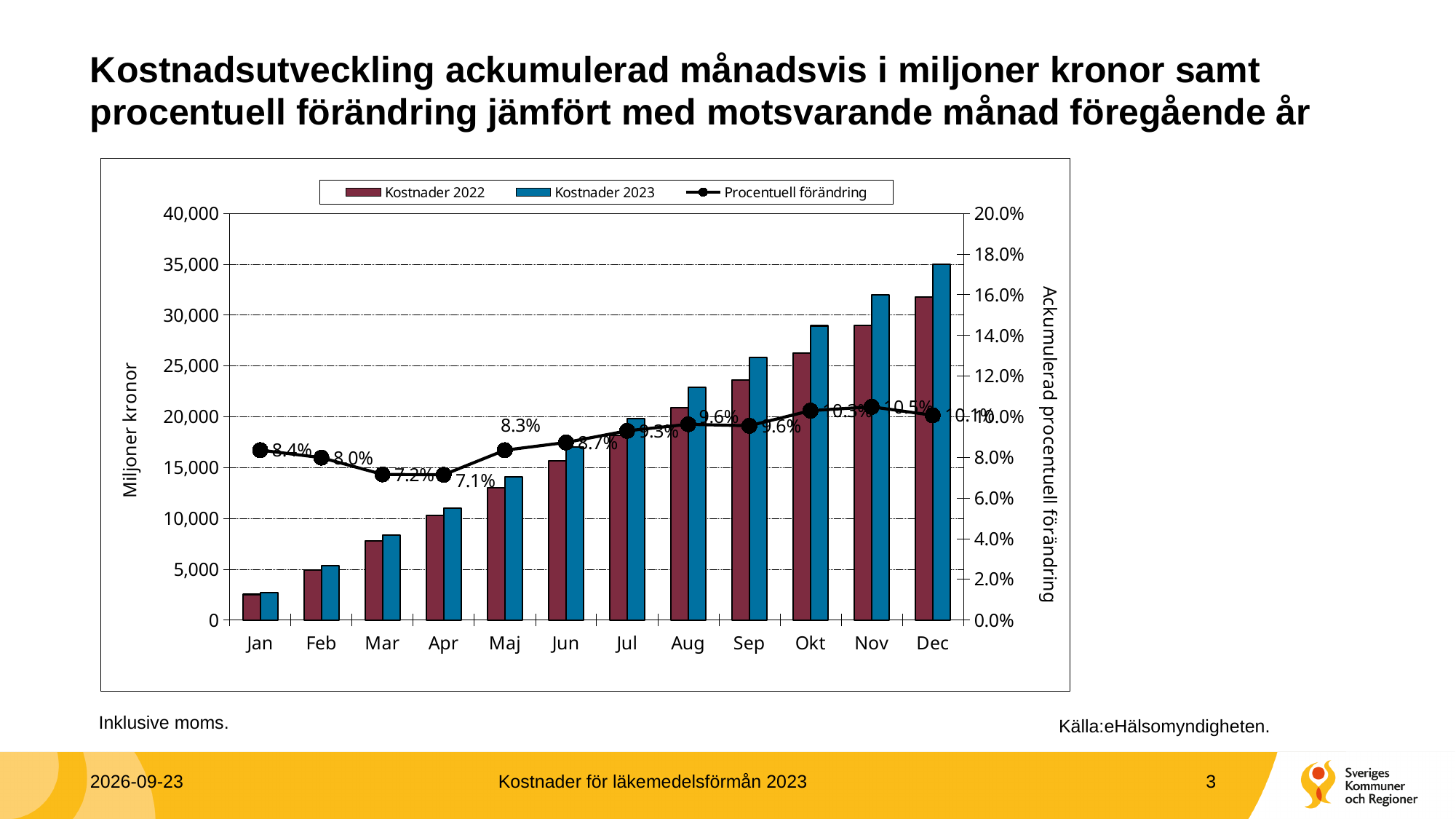
What is the difference between the Procentuell förändring for Jan and for Apr? 1.3% How many series does the legend list? 3 What is the Procentuell förändring value for Jan? 8.4% Do the Kostnader 2023 bars rise or fall from Jan to Dec? rise In which month is the Procentuell förändring lowest? Apr What kind of chart is shown on the slide? A bar chart combined with a line How many months are shown on the x axis? 12 Is the Kostnader 2022 value for Dec greater or less than 30,000? greater What is the Procentuell förändring value for Nov? 10.5% What is the Procentuell förändring value for Apr? 7.1% In which month is the Procentuell förändring highest? Nov In Dec, which is larger: Kostnader 2022 or Kostnader 2023? Kostnader 2023